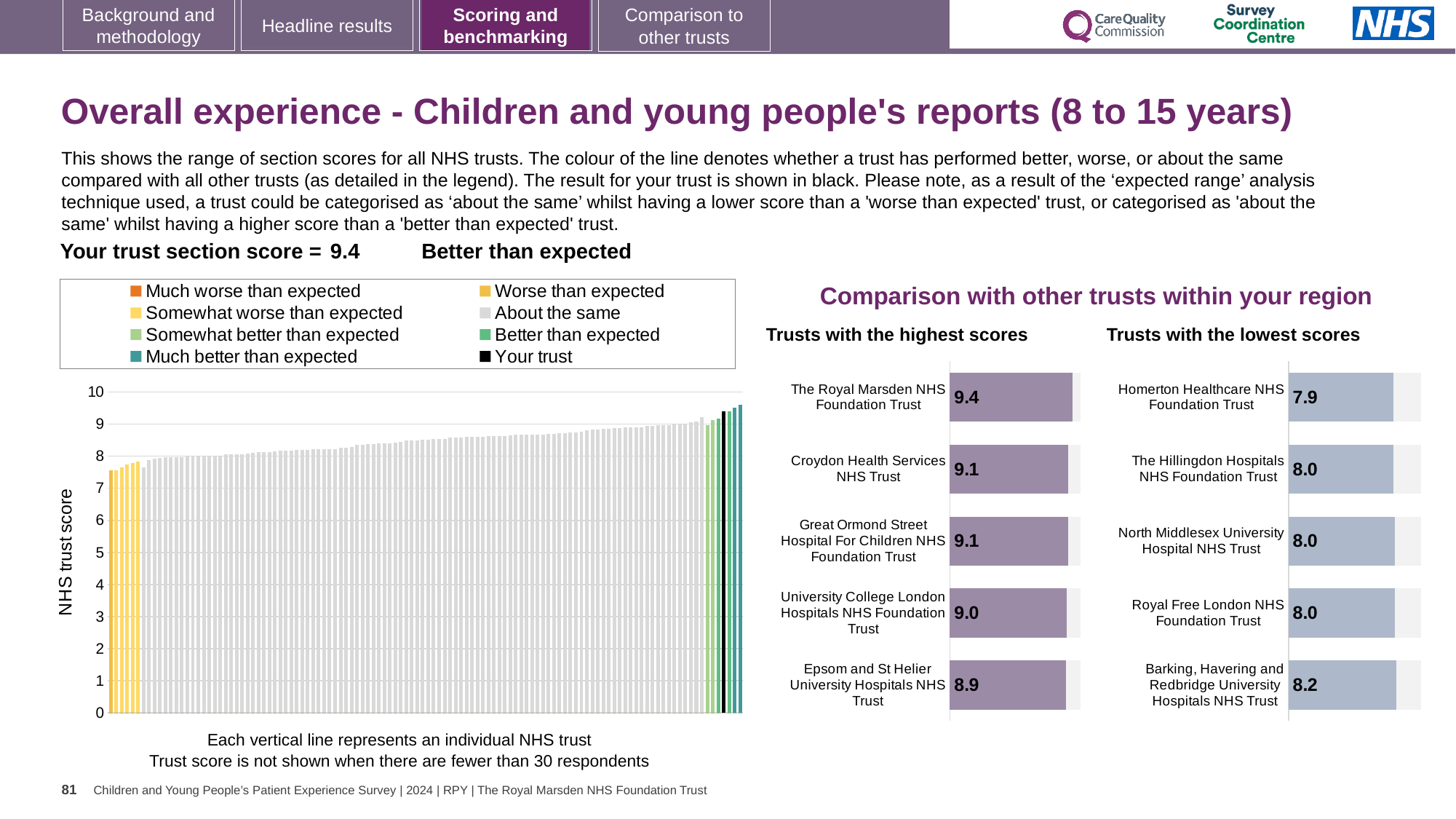
In the 'Trusts with the lowest scores' chart, what is the difference between the scores of Barking, Havering and Redbridge University Hospitals NHS Trust and Homerton Healthcare NHS Foundation Trust? 0.3 In the 'Trusts with the highest scores' chart, what is the difference between the scores of The Royal Marsden NHS Foundation Trust and Epsom and St Helier University Hospitals NHS Trust? 0.5 What kind of chart is the large chart on the left with the y axis 'NHS trust score'? bar chart How many entries does the legend above the left-hand 'NHS trust score' chart list? 8 In the 'Trusts with the highest scores' chart, which has the higher score: Croydon Health Services NHS Trust or University College London Hospitals NHS Foundation Trust? Croydon Health Services NHS Trust In the left-hand 'NHS trust score' chart, is the value of the black bar (your trust) greater or less than 9? greater In the 'Trusts with the lowest scores' chart, which trust has the lowest score? Homerton Healthcare NHS Foundation Trust What is the y-axis label of the large chart on the left? NHS trust score In the 'Trusts with the highest scores' chart, what is the score for The Royal Marsden NHS Foundation Trust? 9.4 In the 'Trusts with the lowest scores' chart, what is the score for Homerton Healthcare NHS Foundation Trust? 7.9 How many trusts are shown in the 'Trusts with the lowest scores' chart? 5 In the 'Trusts with the highest scores' chart, which trust has the highest score? The Royal Marsden NHS Foundation Trust